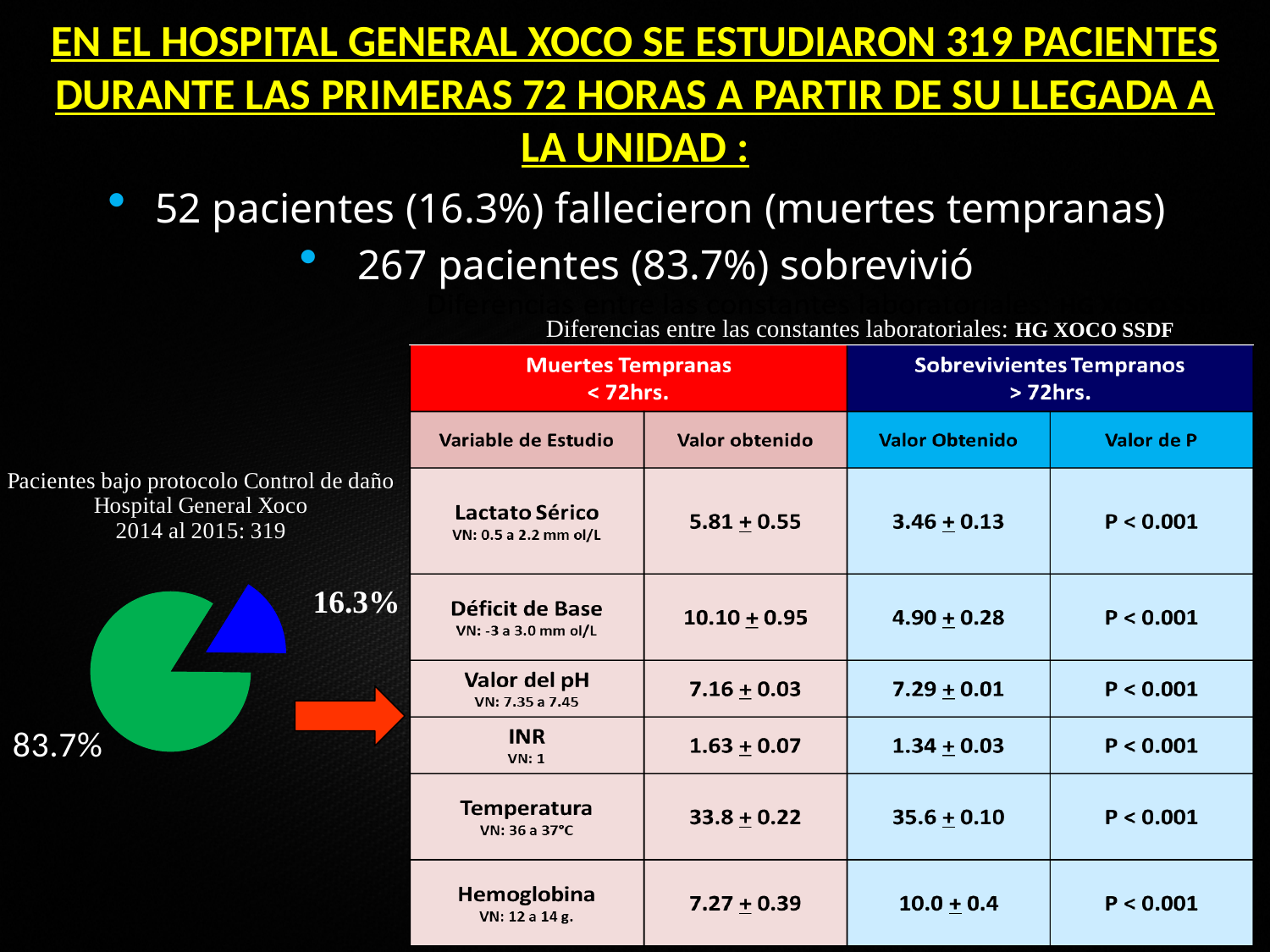
Which slice of the pie chart is the smallest? the blue slice (16.3%) What is the difference in percentage points between the green slice and the blue slice of the pie chart? 67.4 What years are mentioned in the pie chart's title? 2014 al 2015 What share of the pie chart does the blue slice represent? 16.3% What kind of chart is shown on the left of the slide? pie chart How many slices does the pie chart have? 2 Which slice of the pie chart is the largest? the green slice (83.7%) What share of the pie chart does the green slice represent? 83.7% What is the total number of patients stated in the pie chart's title? 319 Is the green slice or the blue slice of the pie chart larger? the green slice